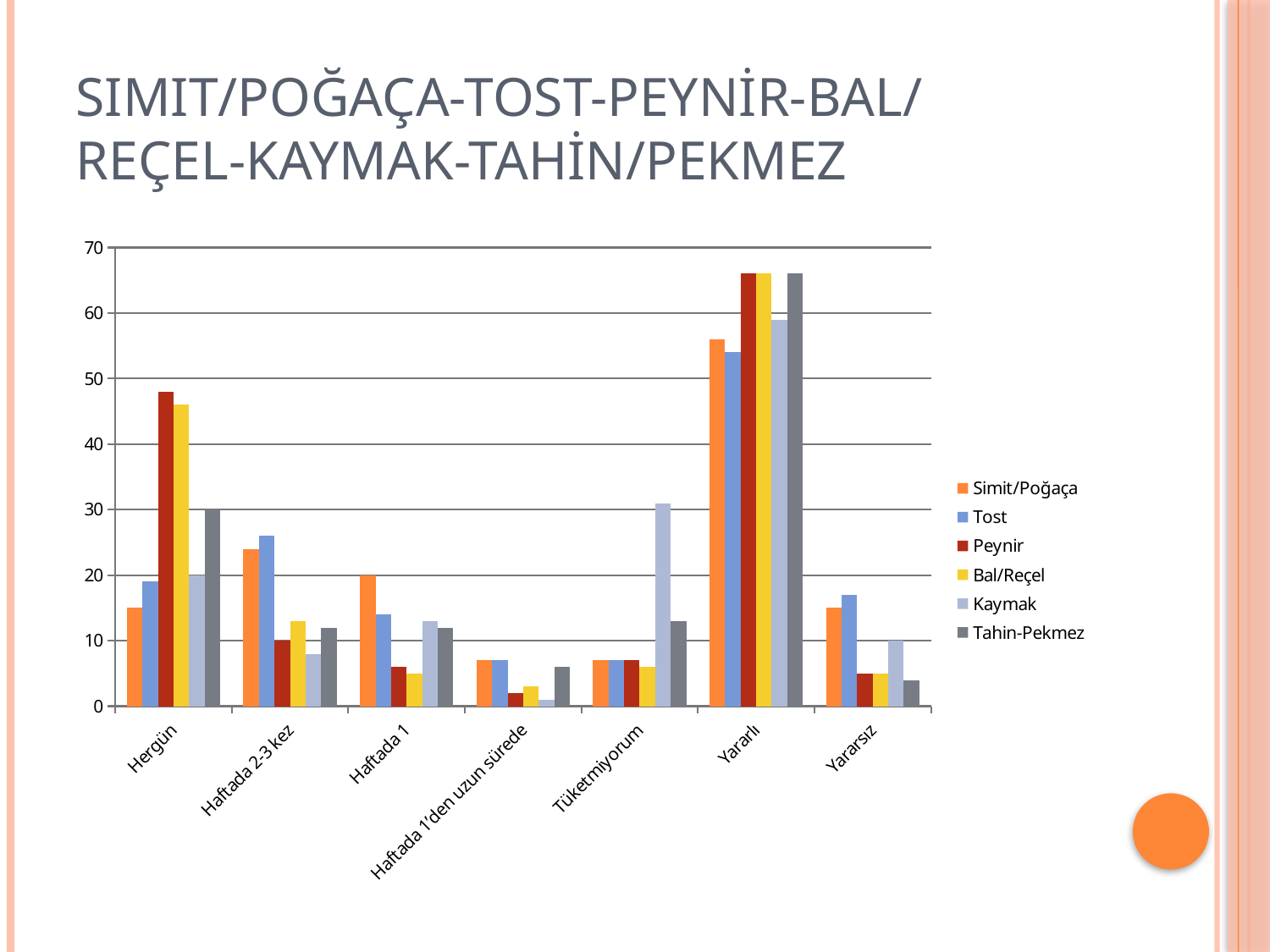
Is the value for Kaymak in Tüketmiyorum greater or less than 20? greater Which series has the lowest value for Haftada 1'den uzun sürede? Kaymak Is the value for Peynir in Hergün greater or less than 40? greater Is the value for Tahin-Pekmez in Yararlı greater or less than 60? greater How many categories are shown on the x axis? 7 Which legend entry is shown in yellow? Bal/Reçel Which series has the highest value for Tüketmiyorum? Kaymak For Hergün, which is larger: Simit/Poğaça or Tost? Tost What kind of chart is shown on the slide? bar chart How many series does the legend list? 6 Which series has the highest value for Haftada 1? Simit/Poğaça